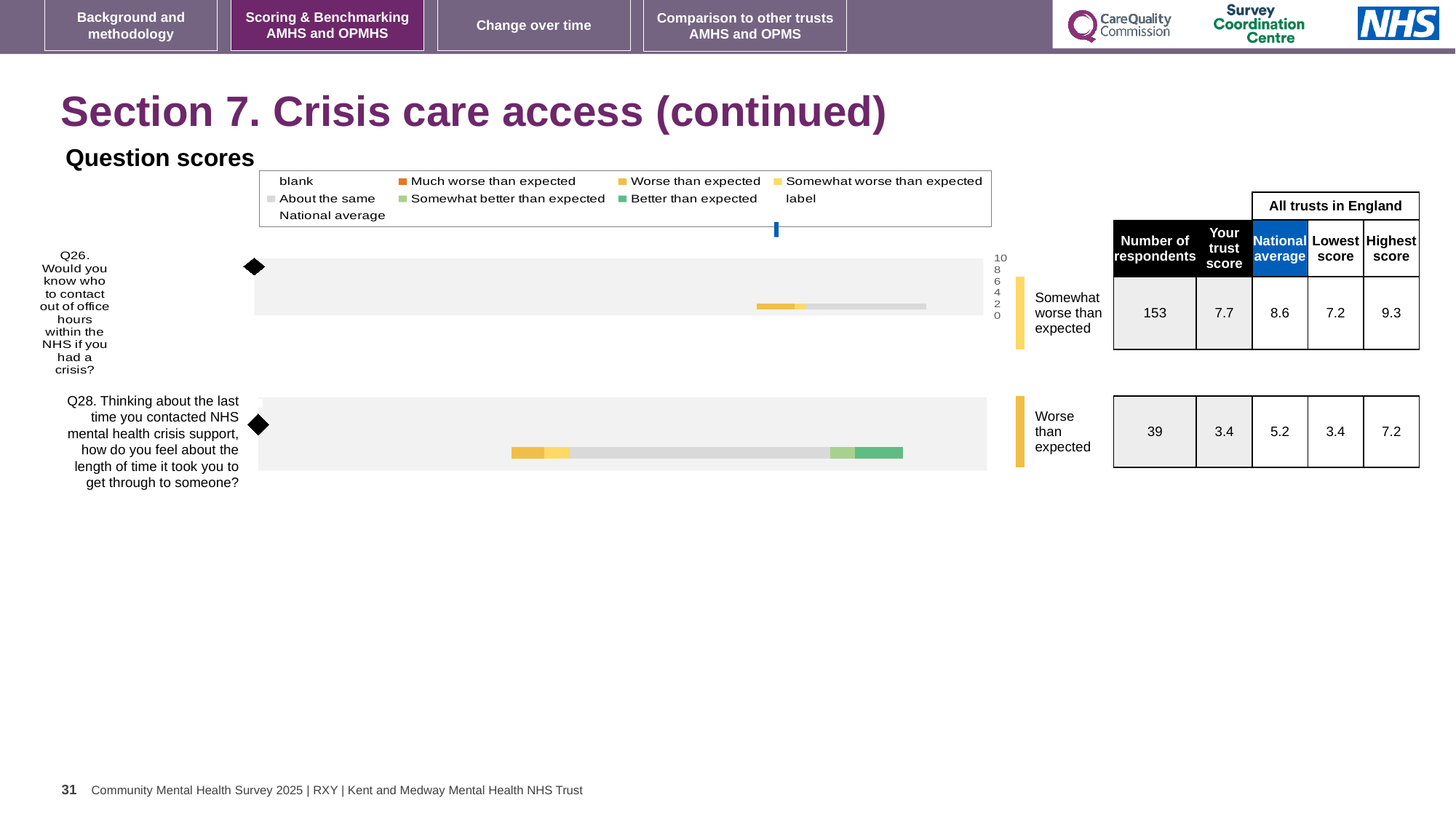
For Q28, what is the national average score? 5.2 For Q26 (Would you know who to contact out of office hours within the NHS if you had a crisis?), what is the trust's score? 7.7 What benchmark rating is shown for Q26? Somewhat worse than expected For Q26, which is larger: the trust's score or the national average? National average For Q28 (length of time it took to get through to someone), what is the trust's score? 3.4 What kind of chart is used to show the question scores? Bar chart For Q26, what is the national average score? 8.6 For Q28, what is the difference between the national average and the trust's score? 1.8 What is the highest score among all trusts in England for Q28? 7.2 How many questions are charted on this slide? 2 How many respondents answered Q26? 153 What benchmark rating is shown for Q28? Worse than expected